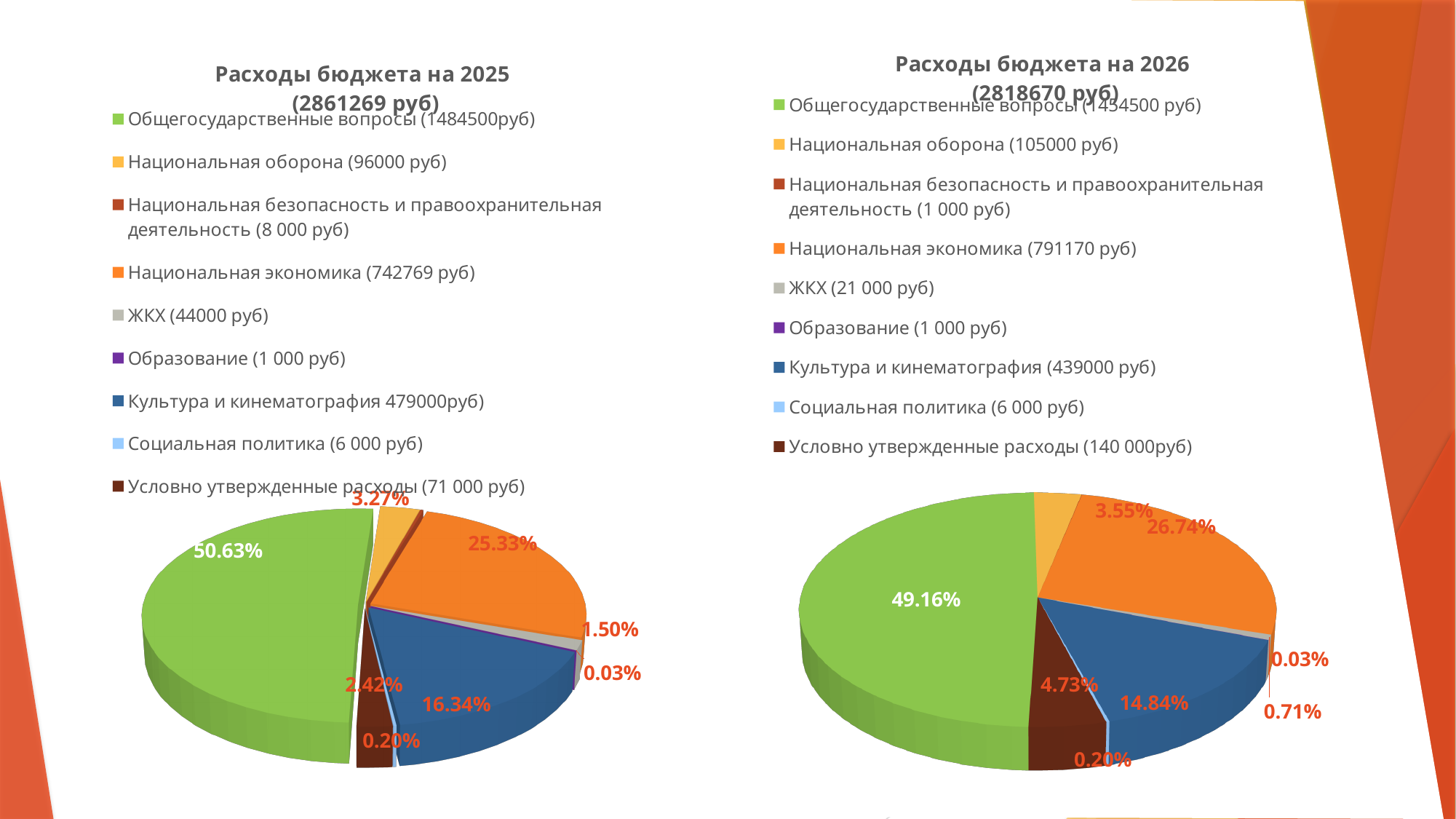
In the 'Расходы бюджета на 2026' chart, what share of the pie is 'Общегосударственные вопросы'? 49.16% Which is larger: the share of 'Национальная экономика' in the 2025 chart or in the 2026 chart? 2026 (26.74%) What total budget amount is shown in the title of the 'Расходы бюджета на 2025' chart? 2861269 руб In the 'Расходы бюджета на 2025' chart, which category has the largest slice? Общегосударственные вопросы How many categories does the legend of the 'Расходы бюджета на 2025' chart list? 9 In the 'Расходы бюджета на 2026' chart, which category has the largest slice? Общегосударственные вопросы What is the difference in percentage points between the 'Общегосударственные вопросы' share in the 2025 chart (50.63%) and in the 2026 chart (49.16%)? 1.47 percentage points What kind of chart is used for 'Расходы бюджета на 2025'? pie chart In the 'Расходы бюджета на 2025' chart, what share of the pie is 'Общегосударственные вопросы'? 50.63% According to the legend of the 'Расходы бюджета на 2026' chart, what is the amount for 'Национальная оборона'? 105000 руб In the 'Расходы бюджета на 2025' chart, what share of the pie is 'Национальная экономика'? 25.33%